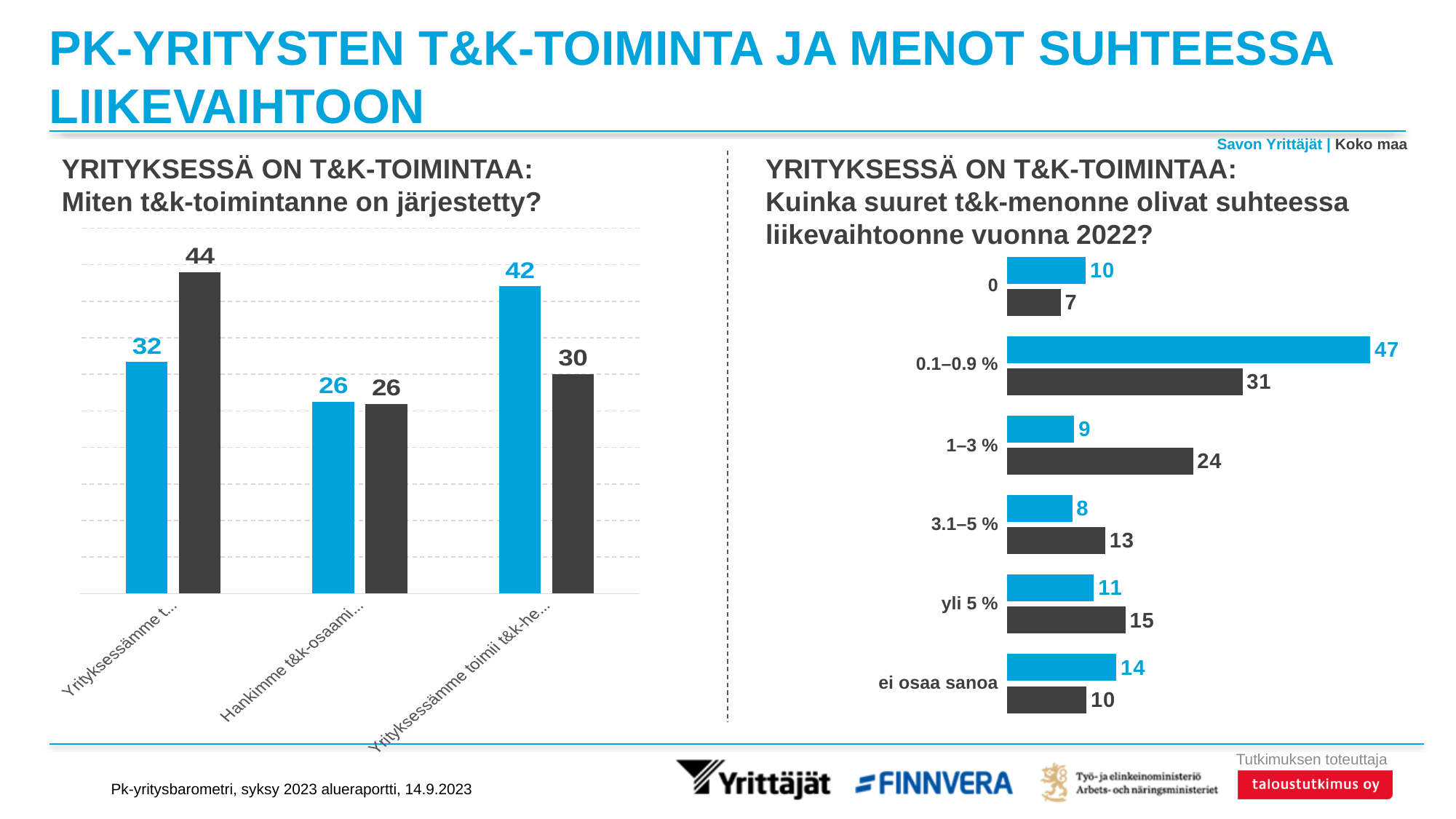
In the right chart (Kuinka suuret t&k-menonne olivat suhteessa liikevaihtoonne vuonna 2022?), which category has the lowest Koko maa value? 0 In the right chart (Kuinka suuret t&k-menonne olivat suhteessa liikevaihtoonne vuonna 2022?), which category has the highest Savon Yrittäjät value? 0.1–0.9 % What kind of chart is the right chart (Kuinka suuret t&k-menonne olivat suhteessa liikevaihtoonne vuonna 2022?)? Horizontal bar chart How many categories does the right chart (Kuinka suuret t&k-menonne olivat suhteessa liikevaihtoonne vuonna 2022?) show? 6 In the left chart (Miten t&k-toimintanne on järjestetty?), what is the Koko maa value for the first category? 44 In the right chart (Kuinka suuret t&k-menonne olivat suhteessa liikevaihtoonne vuonna 2022?), what is the Savon Yrittäjät value for the category 0.1–0.9 %? 47 In the right chart (Kuinka suuret t&k-menonne olivat suhteessa liikevaihtoonne vuonna 2022?), for the category yli 5 %, which is larger: the Savon Yrittäjät value or the Koko maa value? Koko maa In the right chart (Kuinka suuret t&k-menonne olivat suhteessa liikevaihtoonne vuonna 2022?), what is the Koko maa value for the category 1–3 %? 24 How many series does the legend on the slide list? 2 In the right chart (Kuinka suuret t&k-menonne olivat suhteessa liikevaihtoonne vuonna 2022?), what is the difference between the Savon Yrittäjät and Koko maa values for the category 0.1–0.9 %? 16 In the left chart (Miten t&k-toimintanne on järjestetty?), what is the difference between the Koko maa and Savon Yrittäjät values for the first category? 12 In the left chart (Miten t&k-toimintanne on järjestetty?), what is the Savon Yrittäjät value for the third category? 42